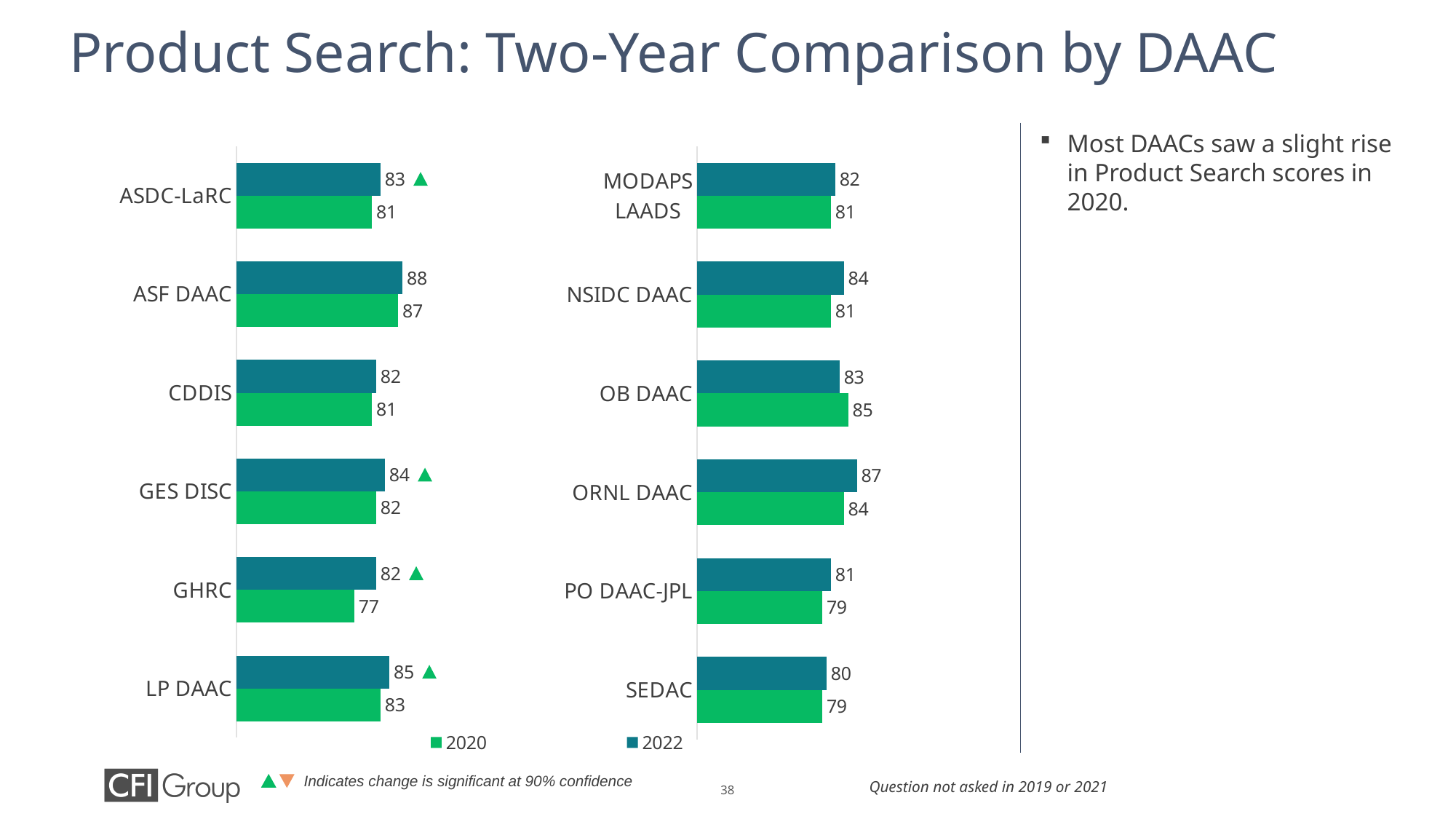
In the left chart, which DAAC has the highest 2022 value? ASF DAAC In the left chart, what is the 2020 value for GHRC? 77 In the right chart, what is the 2022 value for ORNL DAAC? 87 In the left chart, what is the 2022 value for ASF DAAC? 88 In the right chart, what is the 2020 value for OB DAAC? 85 In the right chart, which DAAC has the lowest 2022 value? SEDAC How many DAACs are shown in the left chart? 6 In the right chart, what is the difference between the 2022 and 2020 values for NSIDC DAAC? 3 How many series does the legend list? 2 What type of chart is used on this slide? Bar chart In the left chart, what is the difference between the 2022 and 2020 values for GHRC? 5 In the right chart, is the 2020 value for OB DAAC larger or smaller than its 2022 value? larger